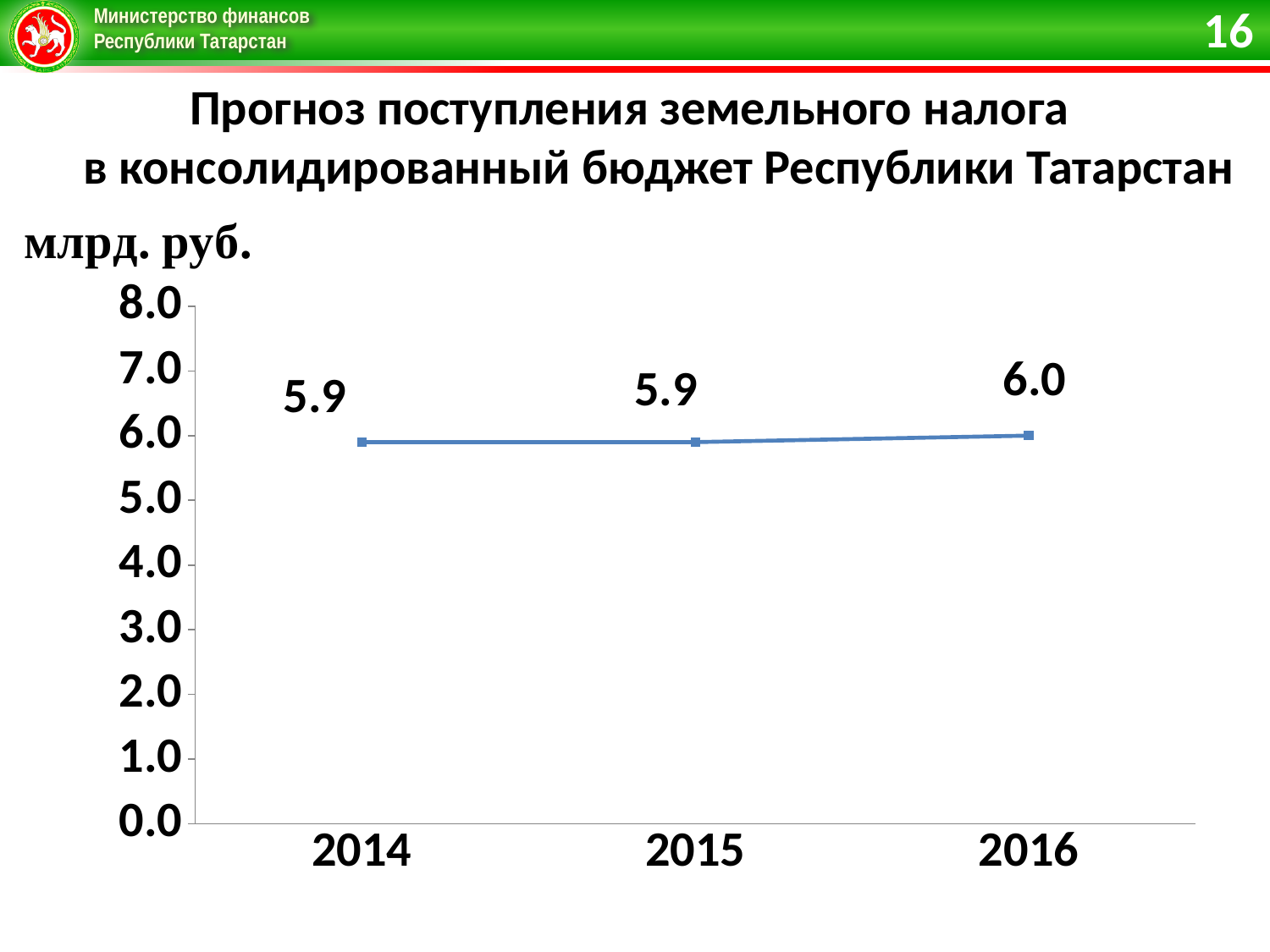
What is the forecast land tax revenue for 2014? 5.9 What unit is shown for the values on the chart? млрд. руб. Is the value for 2015 greater or less than 7.0? less What is the difference between the 2016 and 2015 values? 0.1 What is the forecast land tax revenue for 2015? 5.9 What is the forecast land tax revenue for 2016? 6.0 Which year has the highest forecast land tax revenue? 2016 Is the value for 2016 larger than the value for 2014? Yes How many years are plotted on the chart? 3 What kind of chart is shown on the slide? Line chart What is the maximum value shown on the vertical axis? 8.0 Do the values rise or fall from 2014 to 2016? Rise